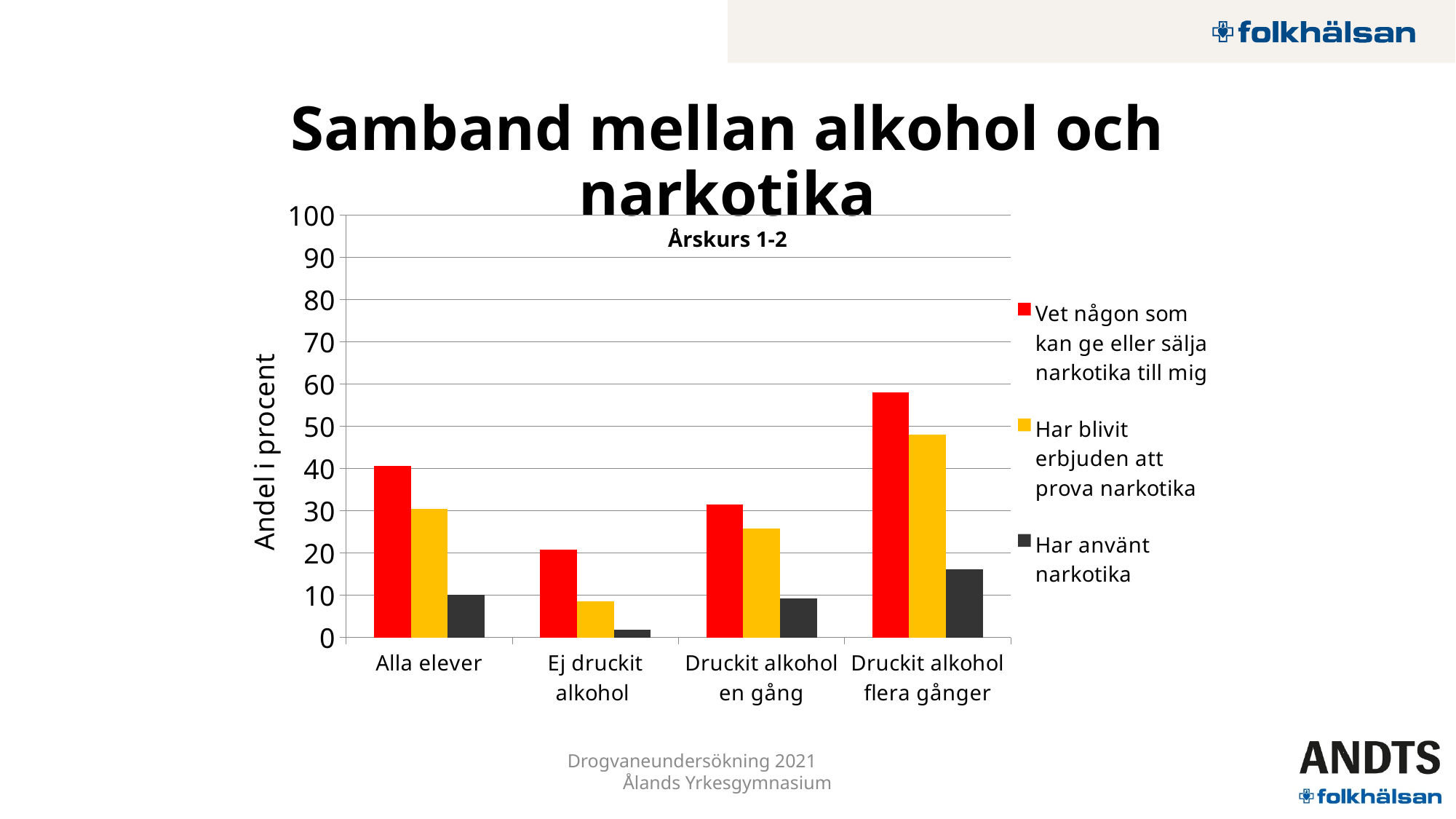
Is the value for 'Har blivit erbjuden att prova narkotika' in the category 'Ej druckit alkohol' greater or less than 10? less Which category has the highest value for the series 'Vet någon som kan ge eller sälja narkotika till mig'? Druckit alkohol flera gånger How many categories are shown on the x axis of the chart? 4 Which category has the lowest value for the series 'Har använt narkotika'? Ej druckit alkohol Is the value for 'Har använt narkotika' in the category 'Druckit alkohol flera gånger' greater or less than 10? greater Is the value for 'Vet någon som kan ge eller sälja narkotika till mig' in the category 'Ej druckit alkohol' greater or less than 30? less What is the label of the vertical axis? Andel i procent What is the title shown inside the chart area? Årskurs 1-2 How many series does the legend list? 3 Which is larger for the series 'Vet någon som kan ge eller sälja narkotika till mig': the value for 'Alla elever' or the value for 'Druckit alkohol en gång'? Alla elever What kind of chart is shown on the slide? bar chart